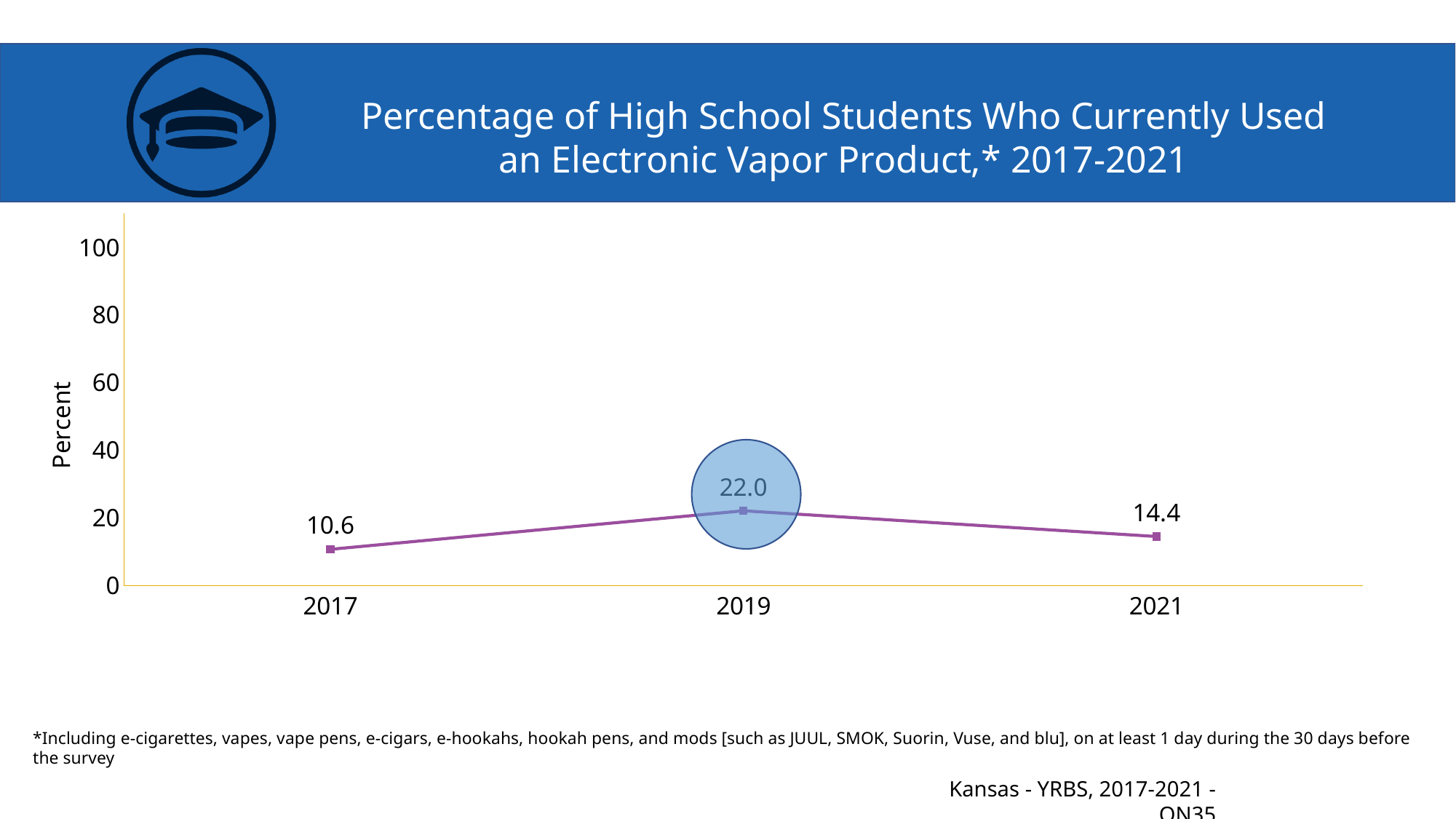
What is the difference between the 2019 and 2021 percentages? 7.6 What is the label on the vertical axis of the chart? Percent What is the difference between the 2019 and 2017 percentages? 11.4 In which year was the percentage of students who currently used an electronic vapor product highest? 2019 What was the percentage of high school students who currently used an electronic vapor product in 2017? 10.6 In which year was the percentage of students who currently used an electronic vapor product lowest? 2017 Which year had a higher percentage, 2017 or 2021? 2021 Is the value for 2019 greater or less than 20? greater How many years are plotted on the chart? 3 What kind of chart is shown on the slide? line chart What was the percentage of high school students who currently used an electronic vapor product in 2019? 22.0 What was the percentage of high school students who currently used an electronic vapor product in 2021? 14.4